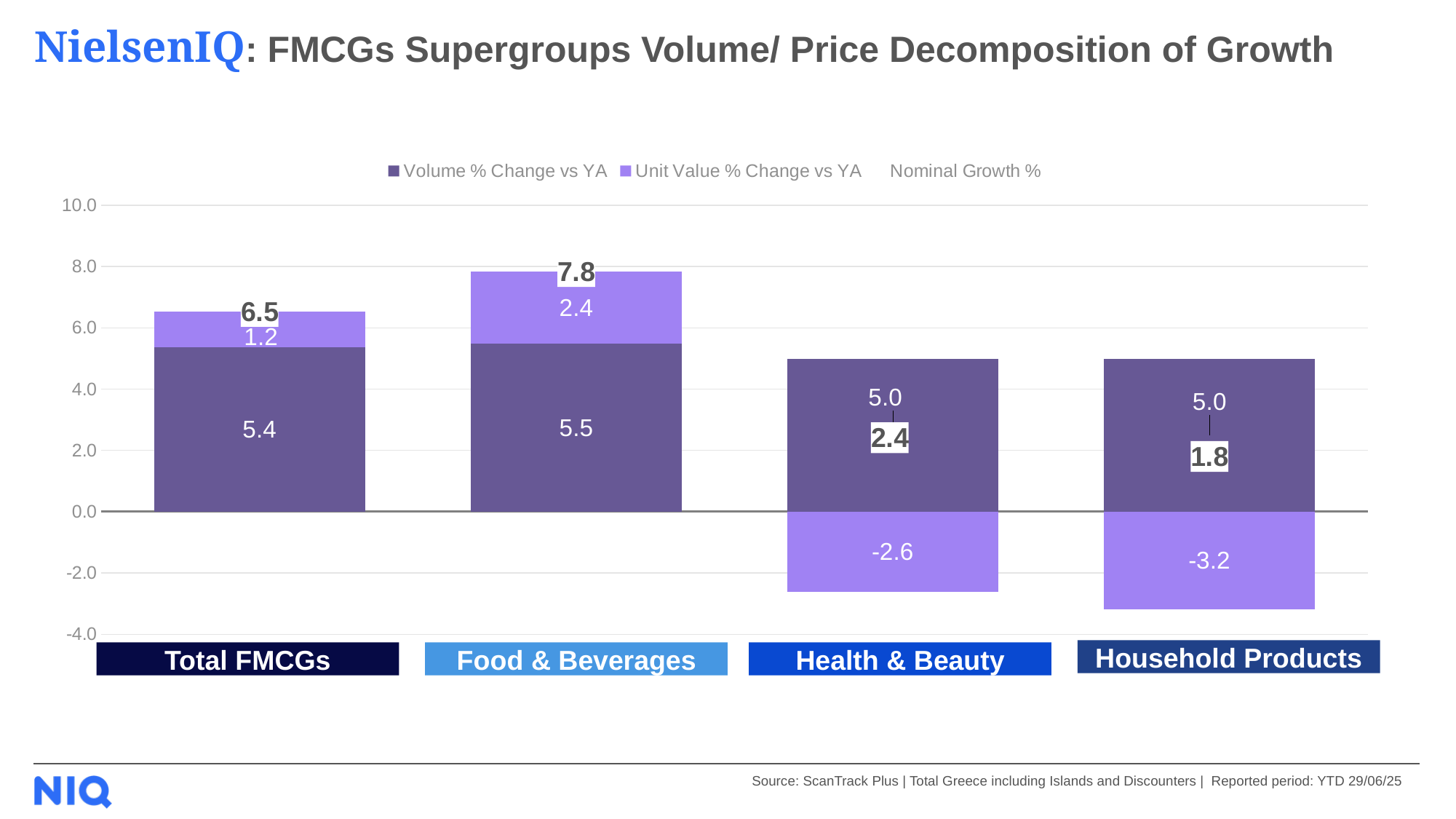
What is the difference between the Nominal Growth % for Health & Beauty and for Household Products? 0.6 How many categories are shown on the x axis? 4 What kind of chart is shown on the slide? Stacked bar chart What is the Volume % Change vs YA for Total FMCGs? 5.4 What is the Unit Value % Change vs YA for Household Products? -3.2 What is the difference between the Volume % Change vs YA for Food & Beverages and for Total FMCGs? 0.1 Which category has the highest Nominal Growth %? Food & Beverages What is the Nominal Growth % for Food & Beverages? 7.8 How many series does the legend list? 3 Which category has the lowest Nominal Growth %? Household Products Which has the larger Unit Value % Change vs YA, Total FMCGs or Food & Beverages? Food & Beverages What is the Unit Value % Change vs YA for Health & Beauty? -2.6